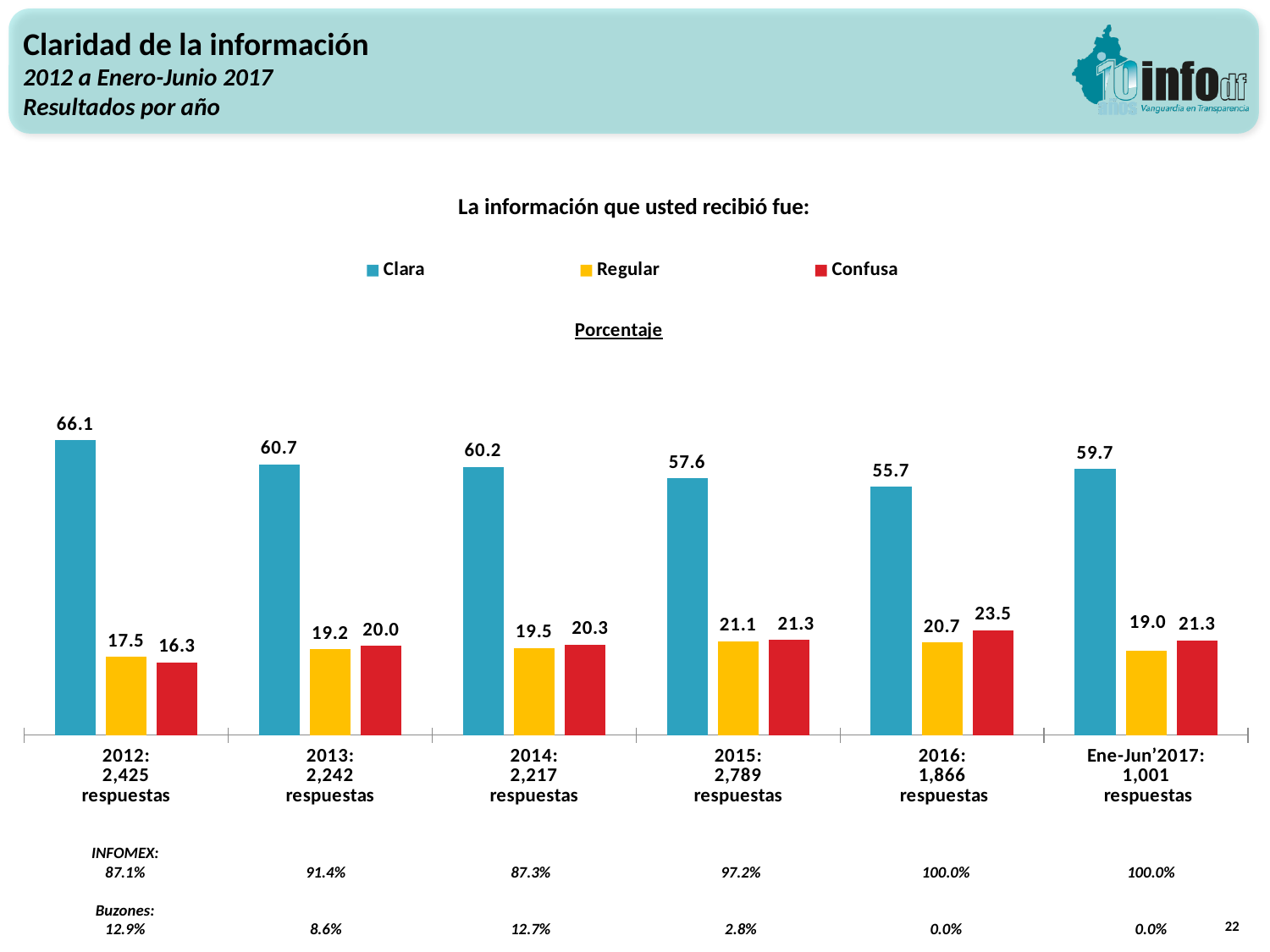
What is the value for Confusa in 2016? 23.5 What kind of chart is shown? Bar chart In which year is the Clara value lowest? 2016 Which is larger in 2012, Regular or Confusa? Regular Which is larger in 2014, Regular or Confusa? Confusa What is the value for Regular in Ene-Jun'2017? 19.0 What is the value for Clara in 2012? 66.1 In which year is the Clara value highest? 2012 How many year categories are shown on the x axis? 6 What is the difference between the Clara values for 2012 and 2016? 10.4 How many series does the legend list? 3 Does the Confusa value rise or fall from 2012 to 2016? Rise